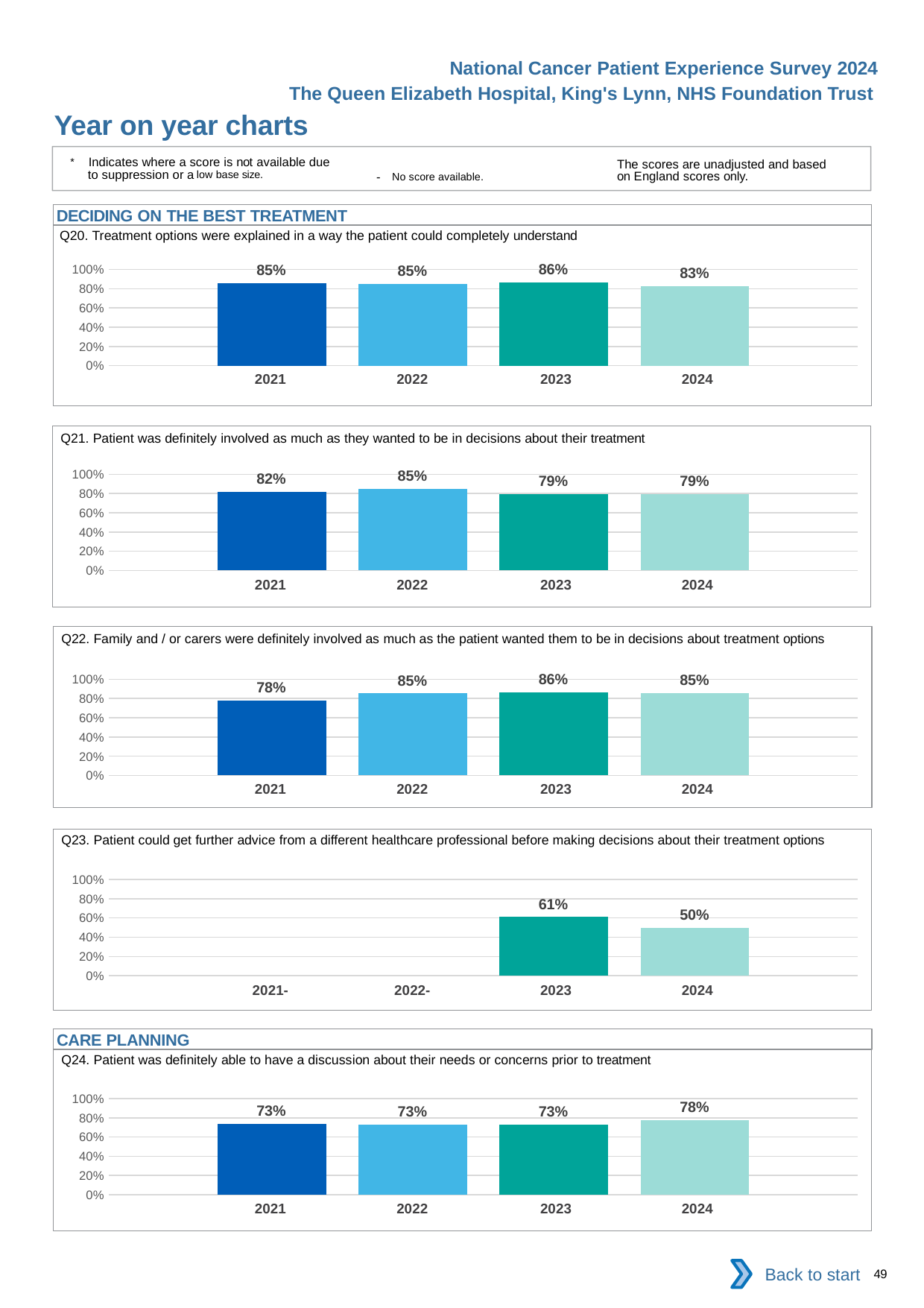
In the Q21 chart, what is the difference between the 2022 value and the 2024 value? 6% In the Q21 chart, which year has the highest value? 2022 In the Q23 chart, how many years have a bar plotted? 2 In the Q23 chart, what is the difference between the 2023 value and the 2024 value? 11% What kind of chart is the Q20 chart? bar chart In the Q22 chart, what is the value for 2023? 86% In the Q23 chart, which is larger, the value for 2023 or the value for 2024? 2023 In the Q24 chart, what is the value for 2024? 78% In the Q22 chart, which year has the lowest value? 2021 In the Q20 chart, what is the value for 2024? 83% In the Q20 chart, which year has the highest value? 2023 In the Q24 chart, is the value for 2021 greater or less than 80%? less